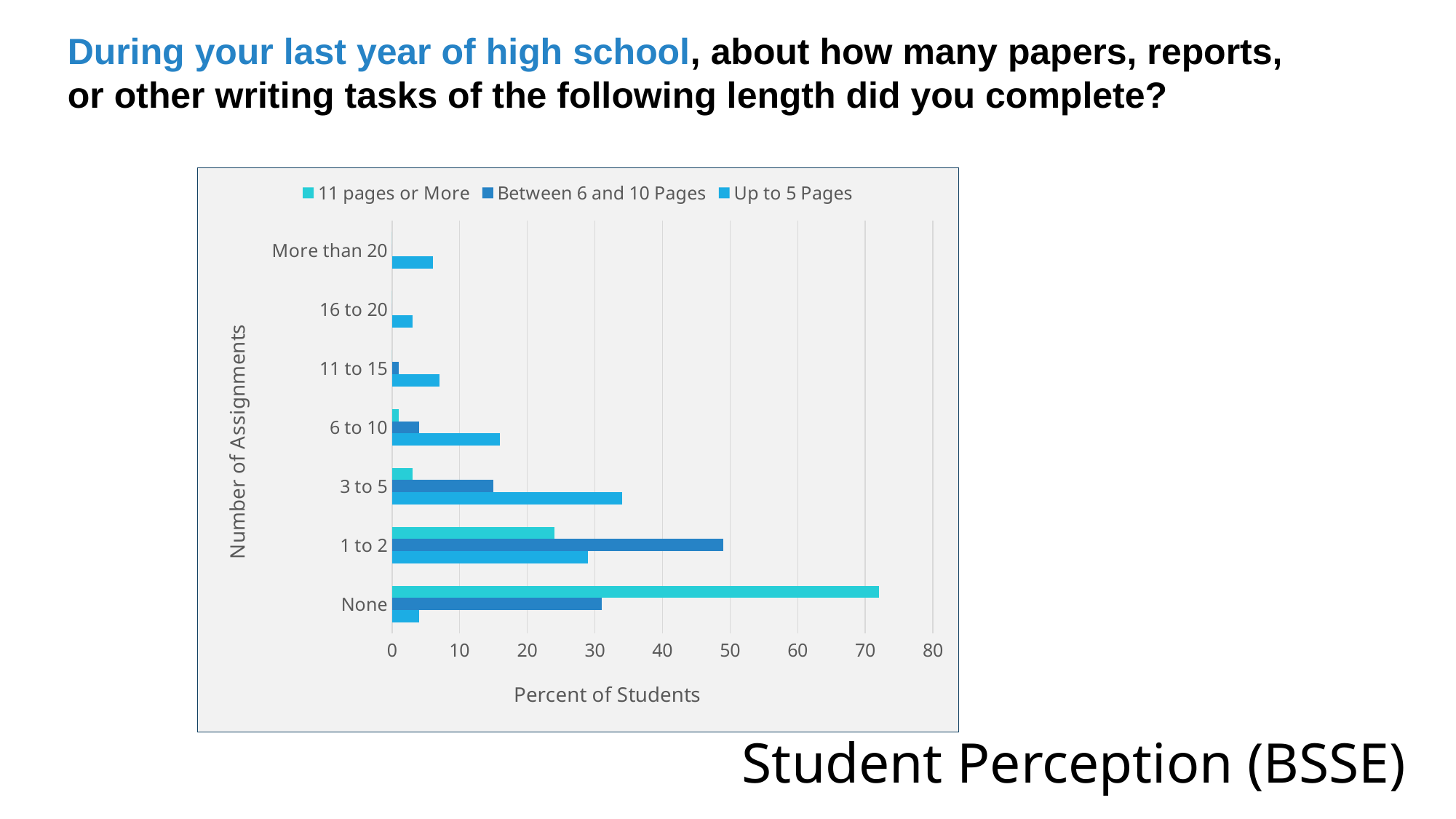
For the '1 to 2' category, which series has the larger value: 'Between 6 and 10 Pages' or 'Up to 5 Pages'? Between 6 and 10 Pages For the 'Up to 5 Pages' series, which category has the highest value? 3 to 5 What is the title of the horizontal axis? Percent of Students How many series does the legend list? 3 For the '11 pages or More' series, which category has the highest value? None For the 'Between 6 and 10 Pages' series, which category has the highest value? 1 to 2 Is the value for 'None' in the '11 pages or More' series greater or less than 60? greater Is the value for '6 to 10' in the 'Up to 5 Pages' series greater or less than 20? less For the 'None' category, which series has the larger value: '11 pages or More' or 'Between 6 and 10 Pages'? 11 pages or More What kind of chart is shown on the slide? bar chart How many assignment-count categories are shown on the y axis? 7 Is the value for '1 to 2' in the 'Between 6 and 10 Pages' series greater or less than 40? greater